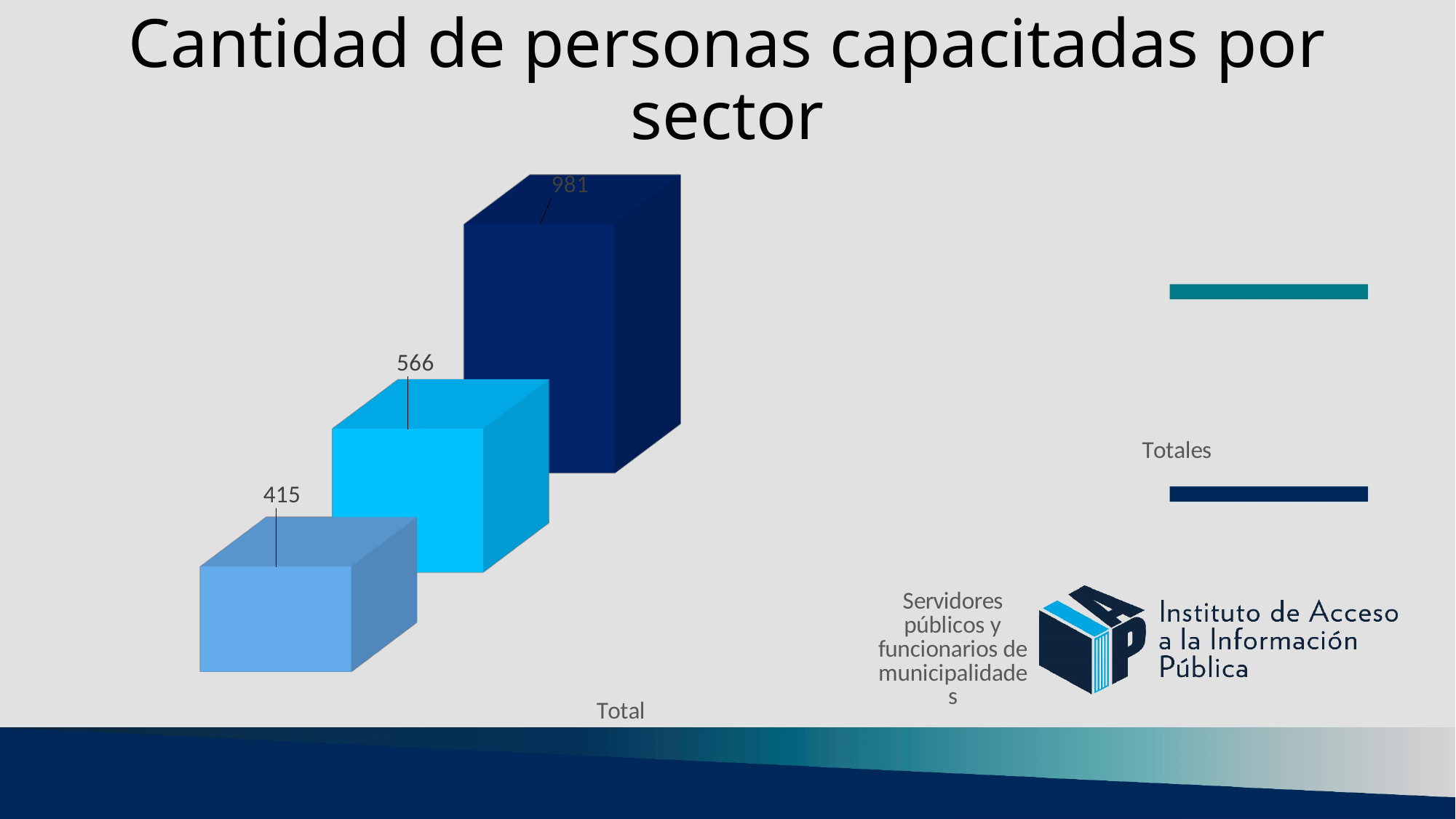
What kind of chart is shown on the slide? bar chart What is the title of the chart on the slide? Cantidad de personas capacitadas por sector What is the value shown on the tallest (dark navy) bar? 981 Which bar is larger, the dark navy bar or the cyan bar? the dark navy bar What is the lowest value labelled in the chart? 415 What is the value shown on the middle (cyan) bar? 566 What is the difference between the middle bar (566) and the shortest bar (415)? 151 What is the value shown on the shortest (light blue, front) bar? 415 What is the highest value labelled in the chart? 981 Do the bar values rise or fall from the front-left bar to the back-right bar? rise What is the difference between the tallest bar (981) and the middle bar (566)? 415 How many bars are plotted in the chart? 3